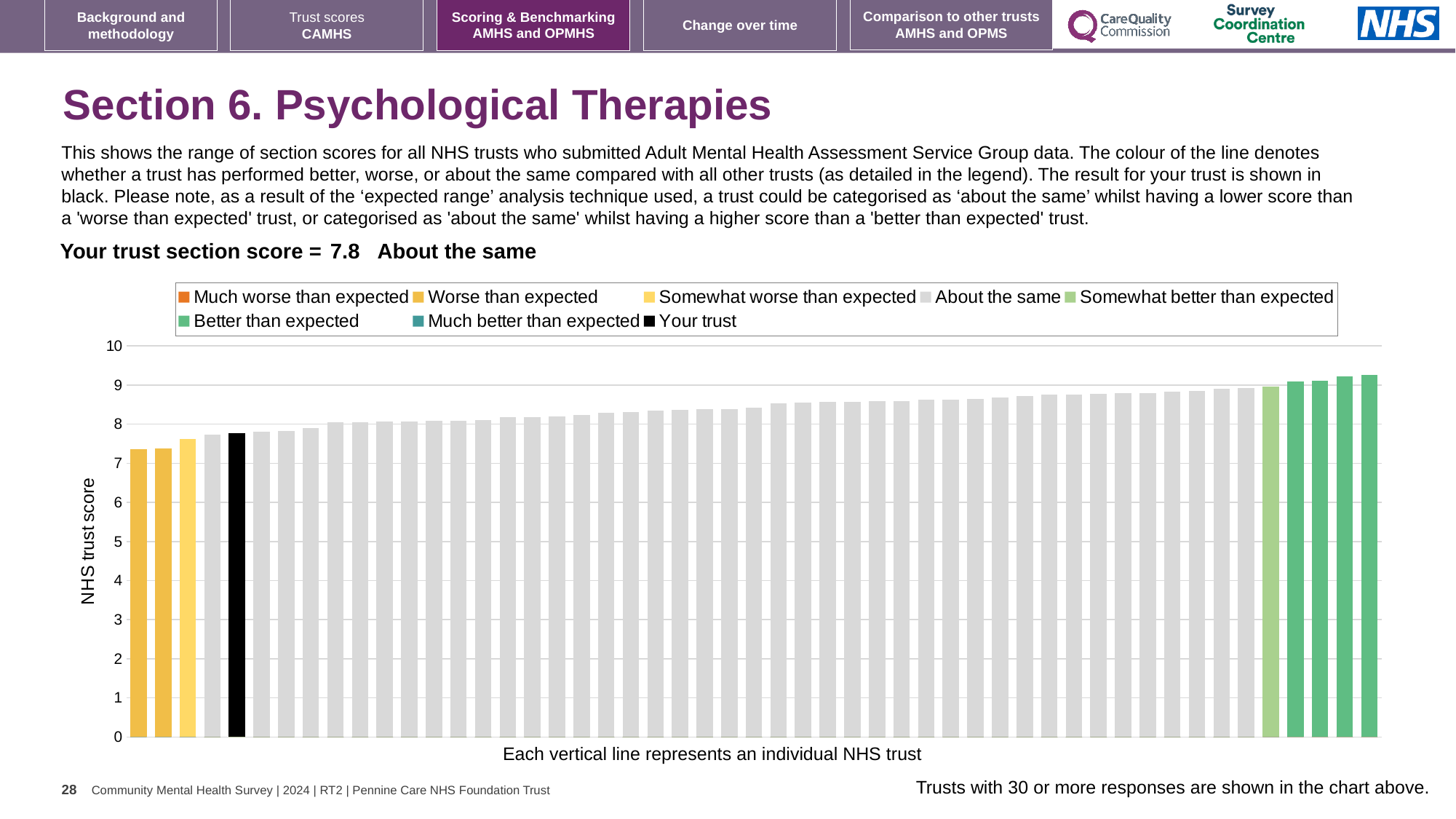
Is the 'Your trust' bar higher or lower than the leftmost bar in the chart? higher Which performance category is your trust placed in for this section? About the same Is the value of the leftmost (lowest) bar greater or less than 8? less How many bars are coloured black in the chart? 1 Is the value of the tallest bar in the chart greater or less than 9? greater Is the value of the black 'Your trust' bar greater or less than 5? greater What does each vertical line in the chart represent, according to the x-axis label? an individual NHS trust What kind of chart is shown on the slide? bar chart What is the section score for your trust shown on the slide? 7.8 How many entries does the chart legend list? 8 What is the label on the vertical axis of the chart? NHS trust score Do the bar values rise or fall from left to right across the chart? rise